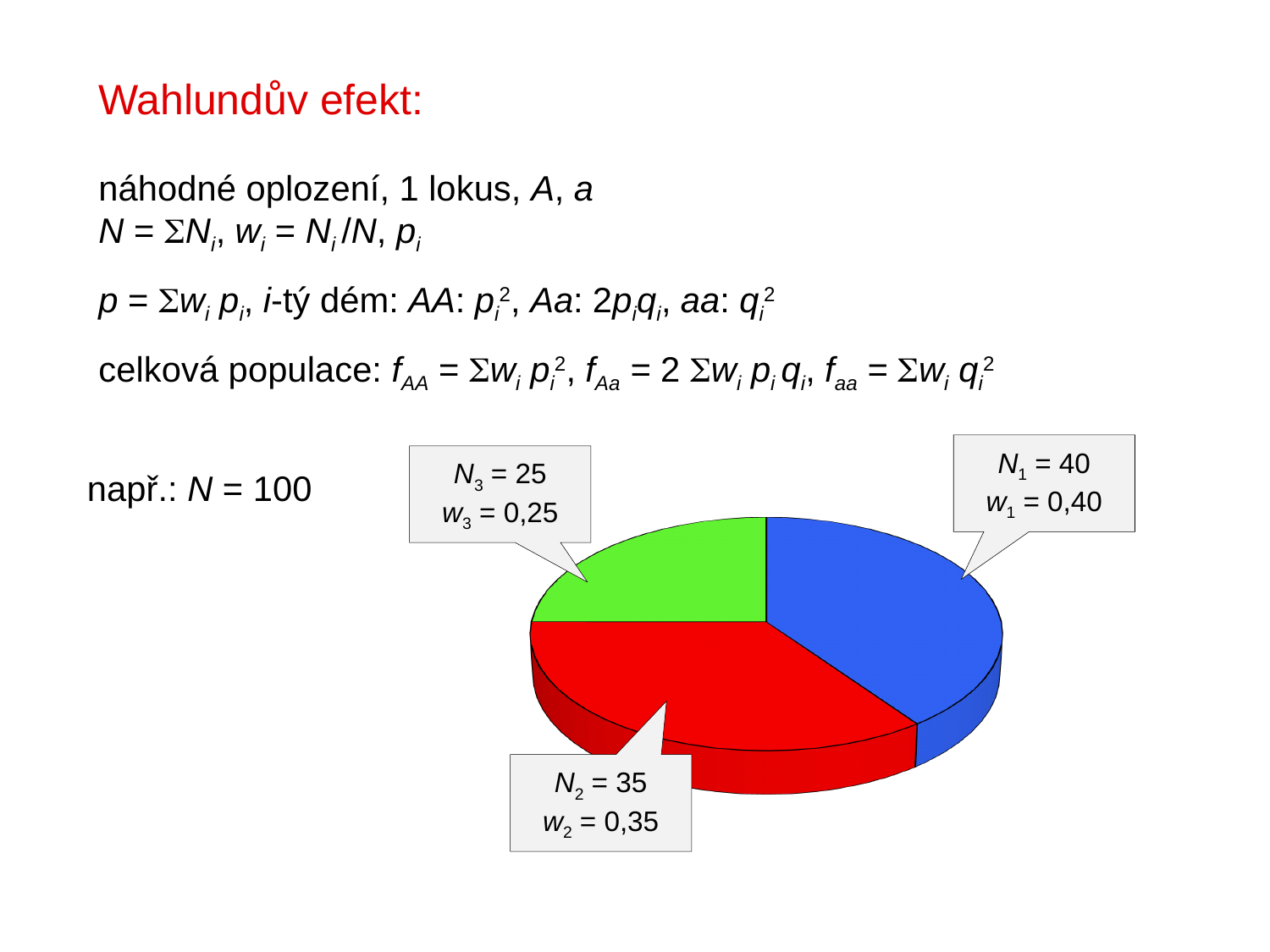
Which slice of the pie chart has the smallest N value? N3 (green slice) What is the value of N2 shown in the callout for the red slice? 35 Which slice of the pie chart has the largest N value? N1 (blue slice) What kind of chart is shown on the slide? pie chart What is the value of w2 shown in the callout for the red slice? 0,35 How many slices does the pie chart have? 3 What share of the pie does the blue slice (N1) represent, as given by w1? 0,40 Which is larger, N2 or N3? N2 What colour is the slice labelled N3 = 25? green What is the value of N1 shown in the callout for the blue slice? 40 What is the value of N3 shown in the callout for the green slice? 25 What is the difference between N1 and N3? 15